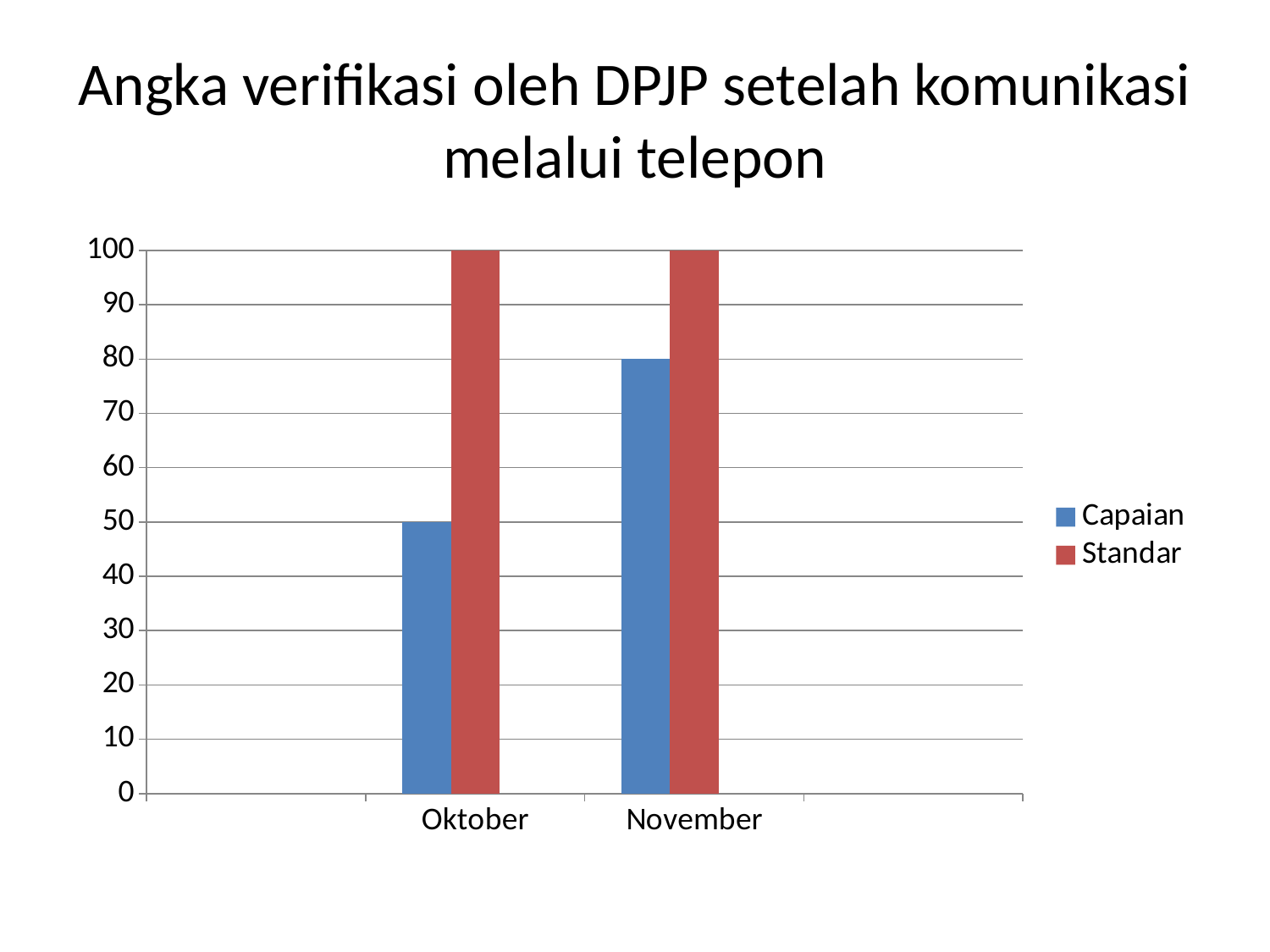
Which month has the higher Capaian value? November What is the Capaian value for Oktober? 50 What is the Standar value for Oktober? 100 By how much did the Capaian value increase from Oktober to November? 30 What kind of chart is shown on the slide? bar chart Which month has the lower Capaian value? Oktober What is the Standar value for November? 100 How many series does the legend list? 2 Is the Capaian value for November larger or smaller than the Standar value for November? smaller What is the Capaian value for November? 80 What is the difference between the Standar and Capaian values for November? 20 What is the difference between the Standar and Capaian values for Oktober? 50